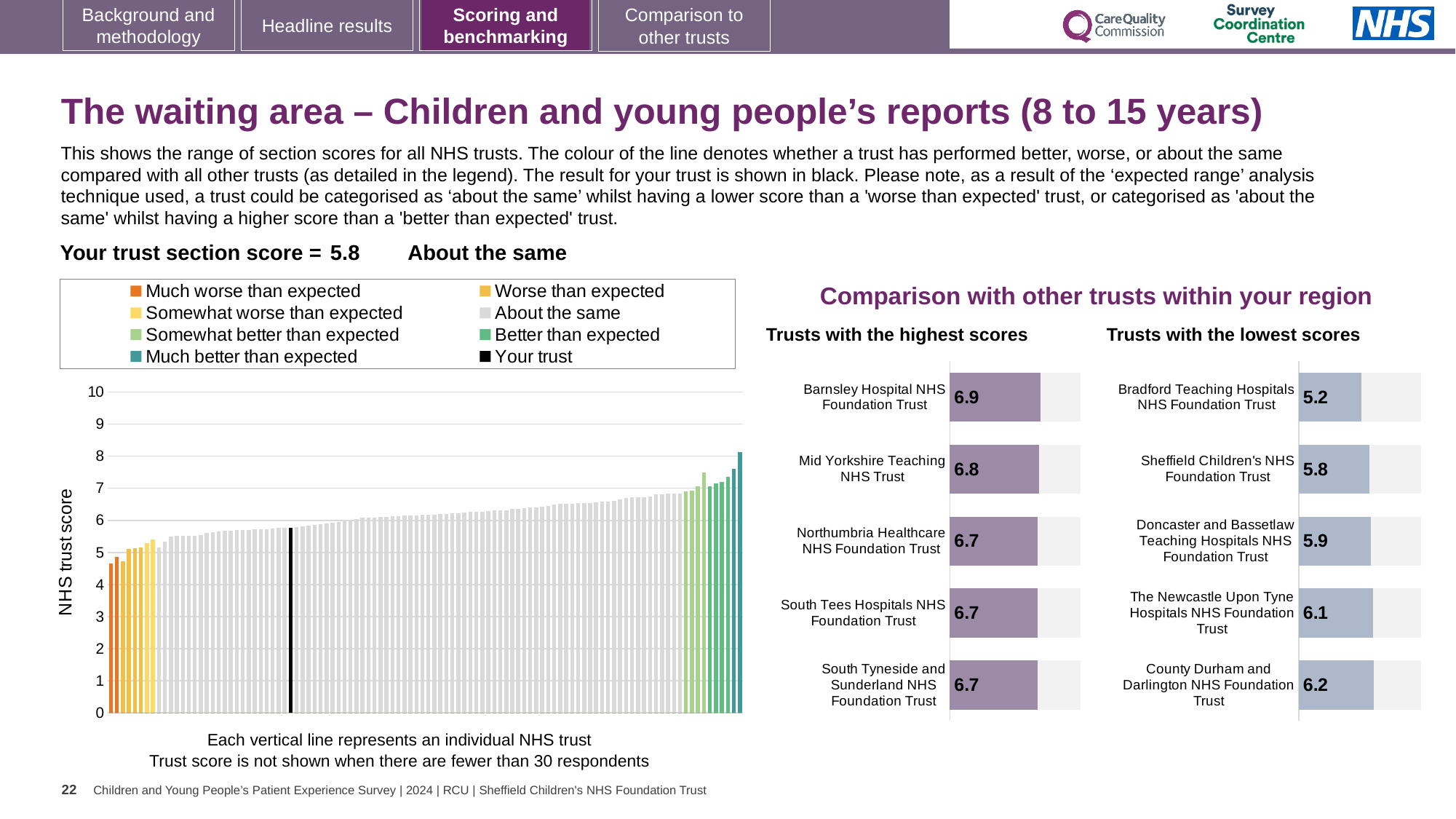
In the 'Trusts with the lowest scores' chart, what is the score for Bradford Teaching Hospitals NHS Foundation Trust? 5.2 In the 'Trusts with the lowest scores' chart, which has the higher score: The Newcastle Upon Tyne Hospitals NHS Foundation Trust or Doncaster and Bassetlaw Teaching Hospitals NHS Foundation Trust? The Newcastle Upon Tyne Hospitals NHS Foundation Trust What kind of chart is the main chart on the left of the slide? bar chart In the 'Trusts with the highest scores' chart, what is the difference between the scores of Barnsley Hospital NHS Foundation Trust and Mid Yorkshire Teaching NHS Trust? 0.1 How many entries does the legend of the main chart on the left list? 8 In the 'Trusts with the lowest scores' chart, which trust has the lowest score? Bradford Teaching Hospitals NHS Foundation Trust In the main chart on the left, is the value of the black bar (your trust) greater or less than 6? less In the main chart on the left, is the value of the lowest bar greater or less than 5? less In the 'Trusts with the highest scores' chart, what is the score for Barnsley Hospital NHS Foundation Trust? 6.9 How many trusts are shown in the 'Trusts with the highest scores' chart? 5 In the 'Trusts with the highest scores' chart, which trust has the highest score? Barnsley Hospital NHS Foundation Trust In the 'Trusts with the lowest scores' chart, what is the difference between the scores of County Durham and Darlington NHS Foundation Trust and Bradford Teaching Hospitals NHS Foundation Trust? 1.0